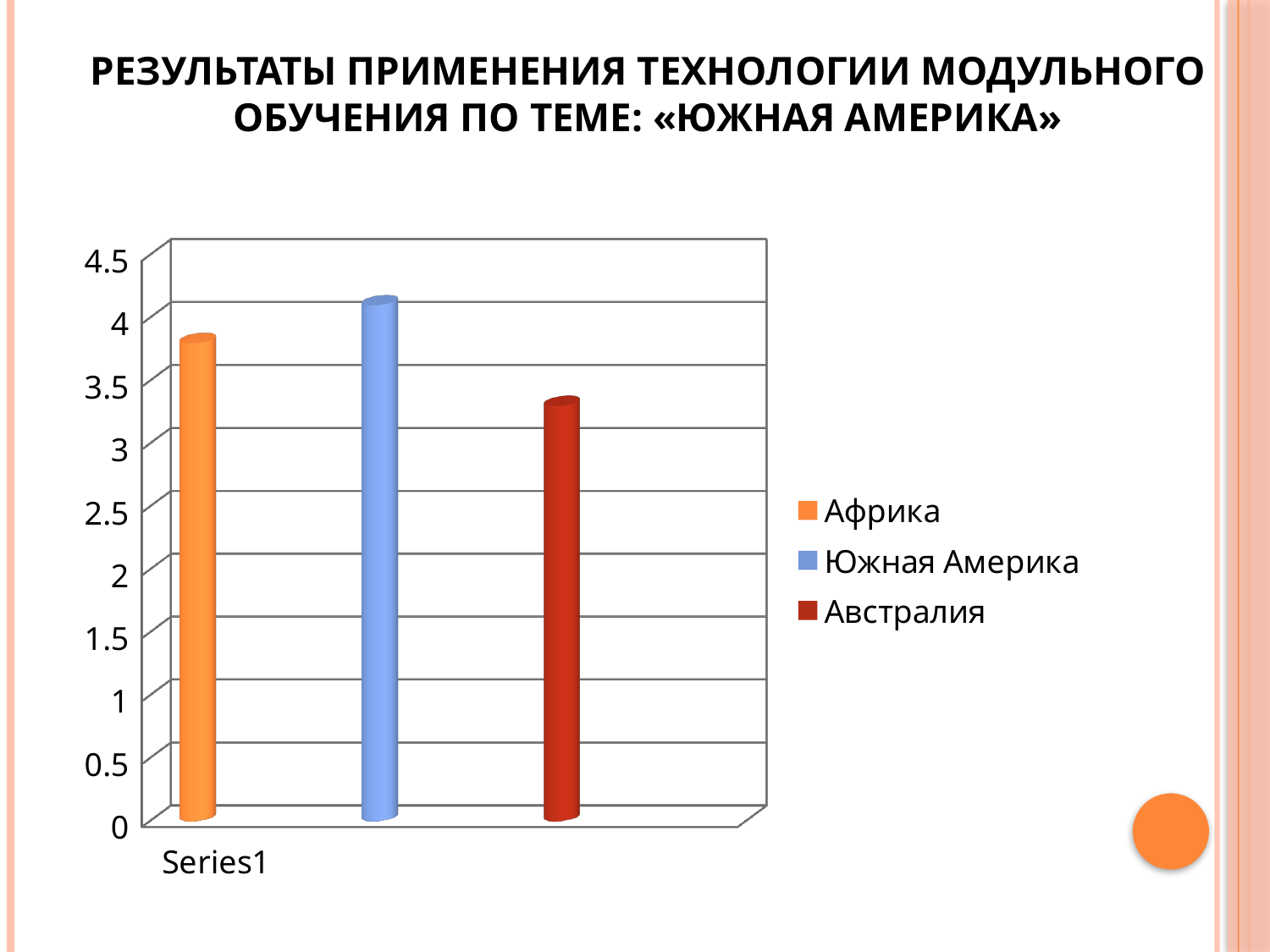
Which legend entry has the highest bar? Южная Америка Which is larger, the bar for Южная Америка or the bar for Африка? Южная Америка Which is larger, the bar for Африка or the bar for Австралия? Африка What kind of chart is shown on the slide? bar chart Is the value for Австралия greater or less than 3? greater How many bars are plotted on the chart? 3 Is the value for Австралия greater or less than 3.5? less Is the value for Африка greater or less than 3.5? greater Which legend entry has the lowest bar? Австралия What colour is the bar for Южная Америка? blue How many entries does the legend list? 3